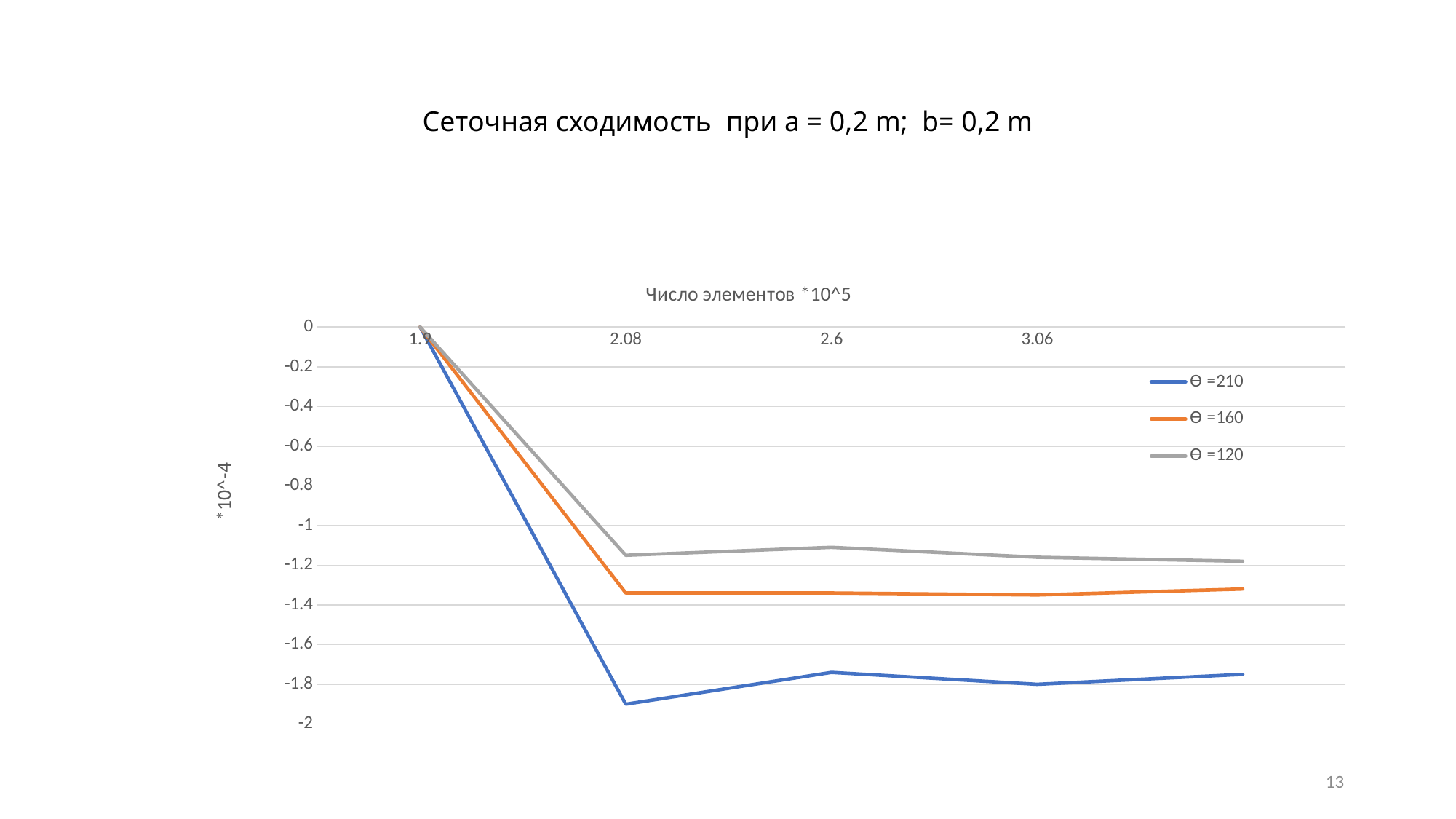
What kind of chart is shown on the slide? line chart Does the Θ =210 series rise or fall from 1.9 to 2.08? fall Which series has the lowest value at 2.08? Θ =210 Is the value of the Θ =160 series at 3.06 greater or less than -1.6? greater How many series does the legend list? 3 At 2.6, which series has the larger value, Θ =120 or Θ =210? Θ =120 Is the value of the Θ =210 series at 2.08 greater or less than -1.8? less What is the title of the chart? Сеточная сходимость при a = 0,2 m; b= 0,2 m Is the value of the Θ =120 series at 2.08 greater or less than -1.2? greater What is the x-axis title of the chart? Число элементов *10^5 Which series has the highest value at 3.06? Θ =120